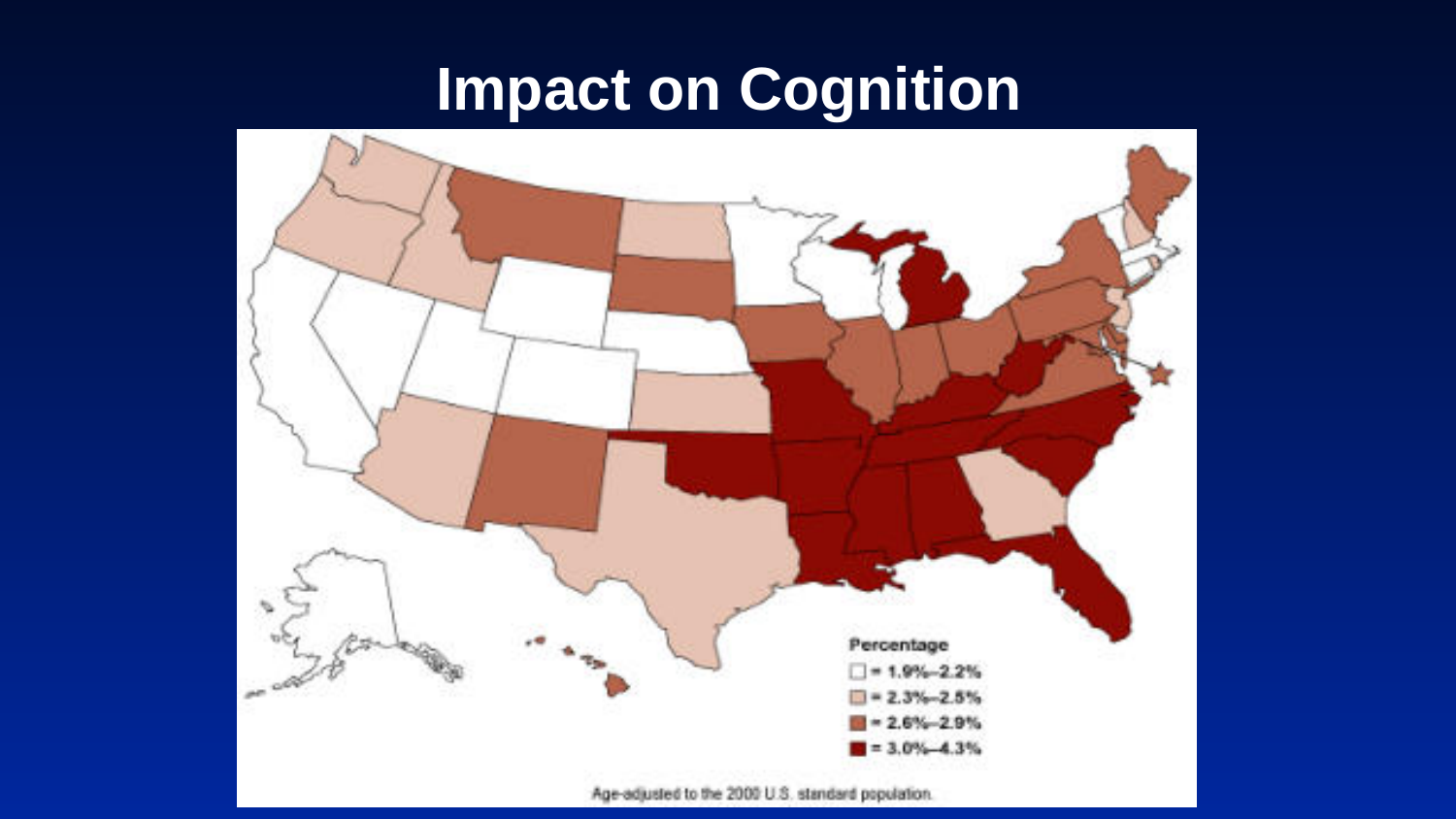
What percentage range does the second-lightest shade in the legend represent? 2.3%–2.5% What is the highest percentage range shown in the legend? 3.0%–4.3% What is the lowest percentage range shown in the legend? 1.9%–2.2% What does the note beneath the map say the data is adjusted to? Age-adjusted to the 2000 U.S. standard population What percentage range does the legend entry just below 2.3%–2.5% represent? 2.6%–2.9% What is the title of the slide? Impact on Cognition How many percentage ranges does the map legend list? 4 What kind of chart is shown on the slide? A map (choropleth map of the United States)